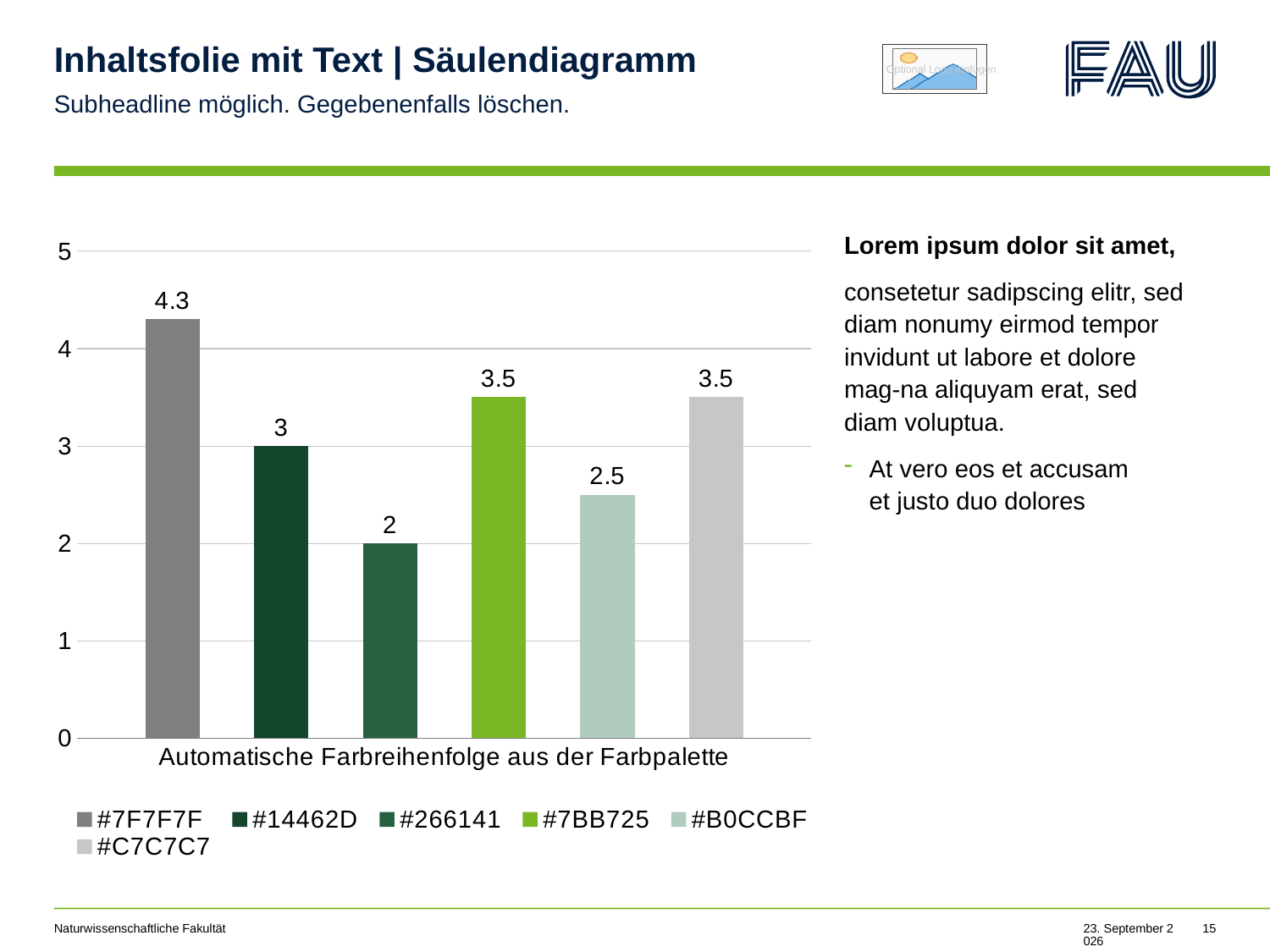
What is the maximum value shown on the y axis? 5 Which series has the highest value? #7F7F7F What is the value of the #7F7F7F series? 4.3 What is the value of the #14462D series? 3 What is the category label shown on the x axis? Automatische Farbreihenfolge aus der Farbpalette Which series has the lowest value? #266141 What is the difference between the values of the #7F7F7F and #14462D series? 1.3 What type of chart is shown on the slide? bar chart What is the value of the #266141 series? 2 What is the value of the #B0CCBF series? 2.5 How many series does the legend list? 6 Which is larger, the value for #7BB725 or the value for #B0CCBF? #7BB725